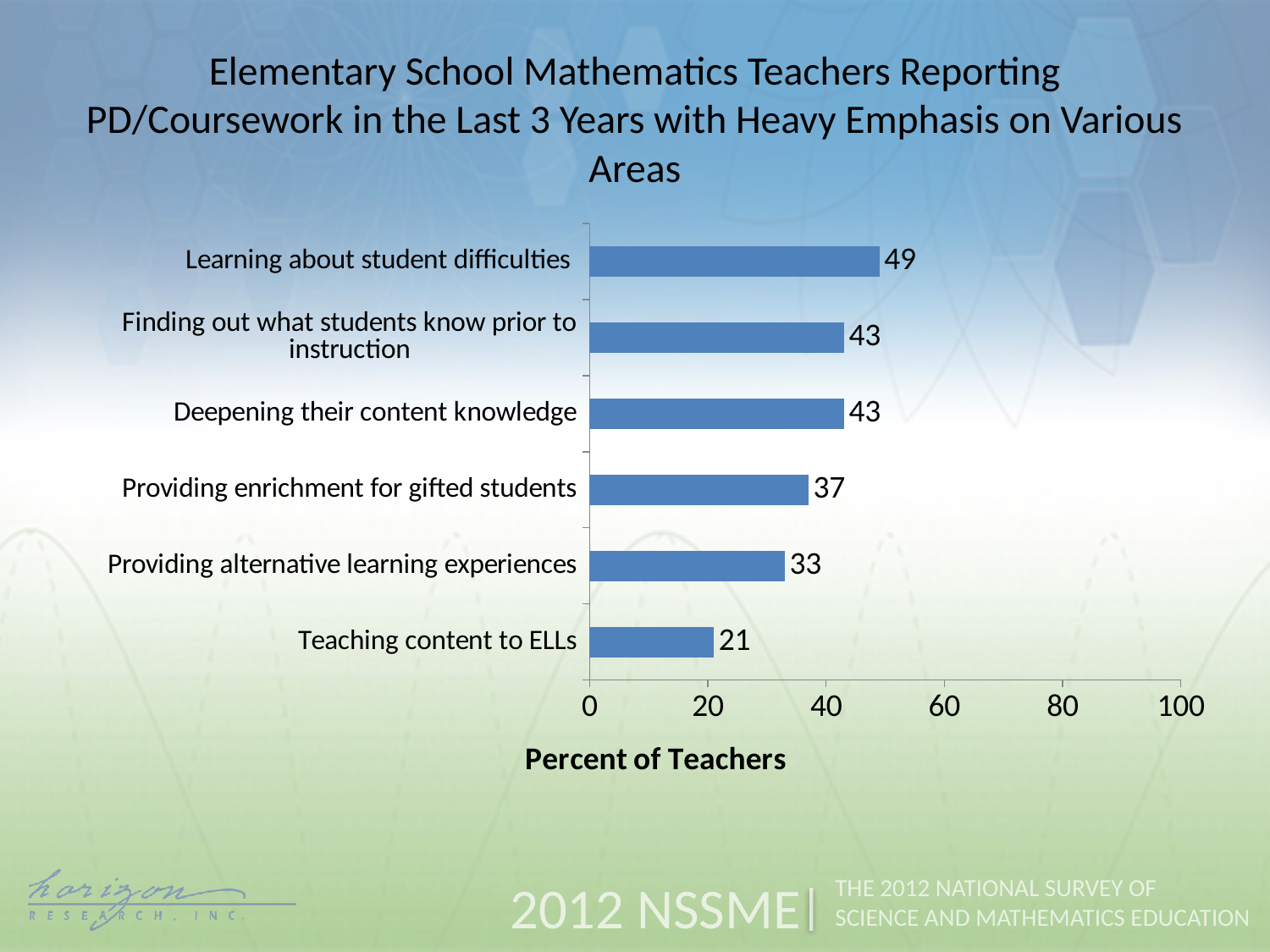
How many areas (categories) are shown in the chart? 6 Which area has the lowest percent of teachers? Teaching content to ELLs Which is larger: the value for Providing enrichment for gifted students or the value for Providing alternative learning experiences? Providing enrichment for gifted students What is the value for Teaching content to ELLs? 21 What is the label of the horizontal axis? Percent of Teachers What is the difference between the values for Learning about student difficulties and Teaching content to ELLs? 28 What kind of chart is shown on the slide? Bar chart What percent of teachers reported PD/coursework with heavy emphasis on learning about student difficulties? 49 Which area has the highest percent of teachers? Learning about student difficulties What is the difference between the values for Deepening their content knowledge and Providing alternative learning experiences? 10 What is the value for Providing alternative learning experiences? 33 What is the value for Providing enrichment for gifted students? 37